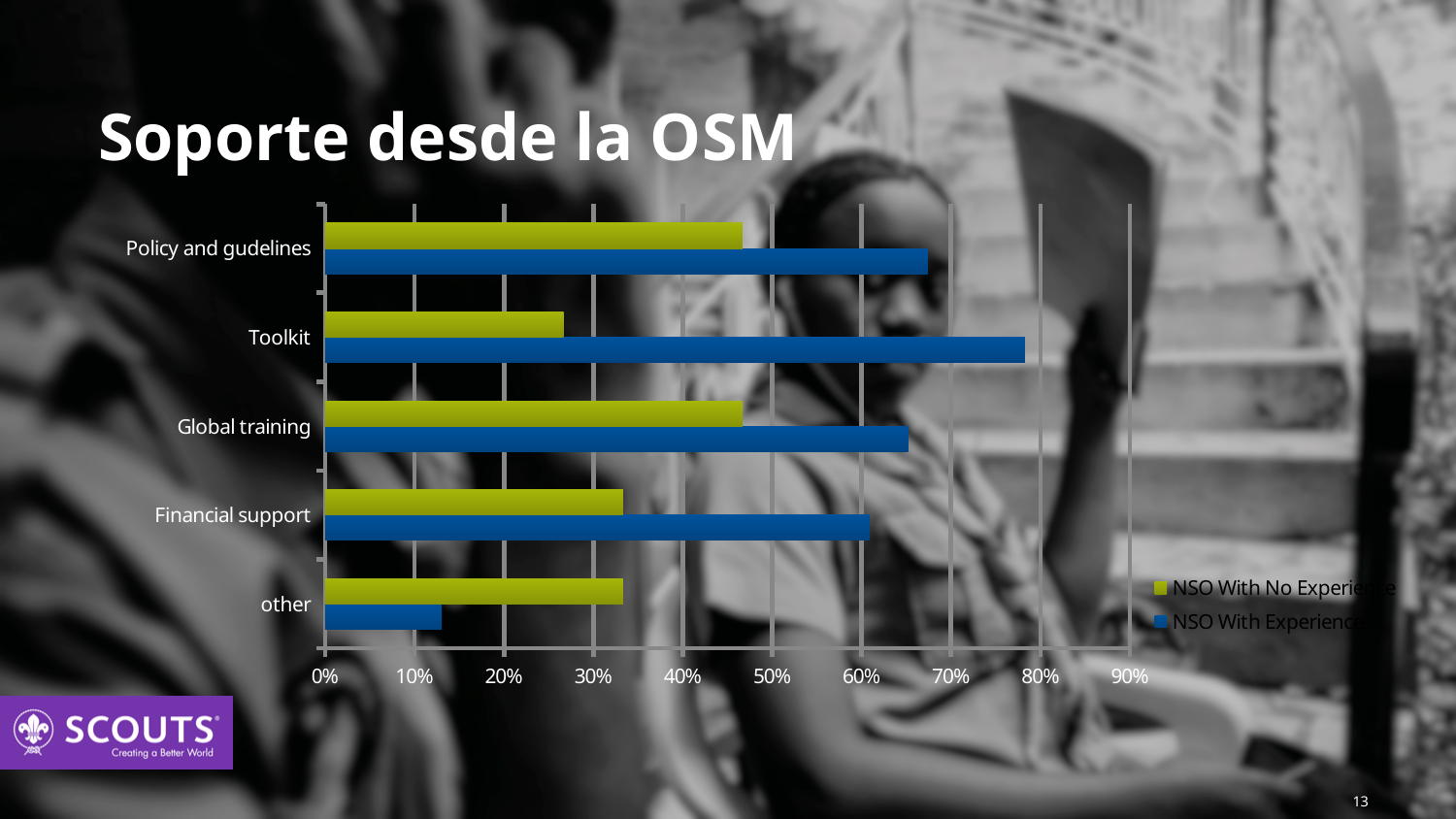
Which category has the lowest value for NSO With No Experience? Toolkit How many series does the legend list? 2 Which category has the lowest value for NSO With Experience? other Which series is shown in green in the legend? NSO With No Experience What is the title of the slide containing the chart? Soporte desde la OSM Which category has the highest value for NSO With Experience? Toolkit Is the value for Toolkit in the NSO With Experience series greater or less than 70%? greater Is the value for other in the NSO With Experience series greater or less than 20%? less For the category other, which series has the larger value, NSO With Experience or NSO With No Experience? NSO With No Experience What kind of chart is shown on the slide? bar chart How many categories are shown on the chart? 5 For Toolkit, which series has the larger value, NSO With Experience or NSO With No Experience? NSO With Experience